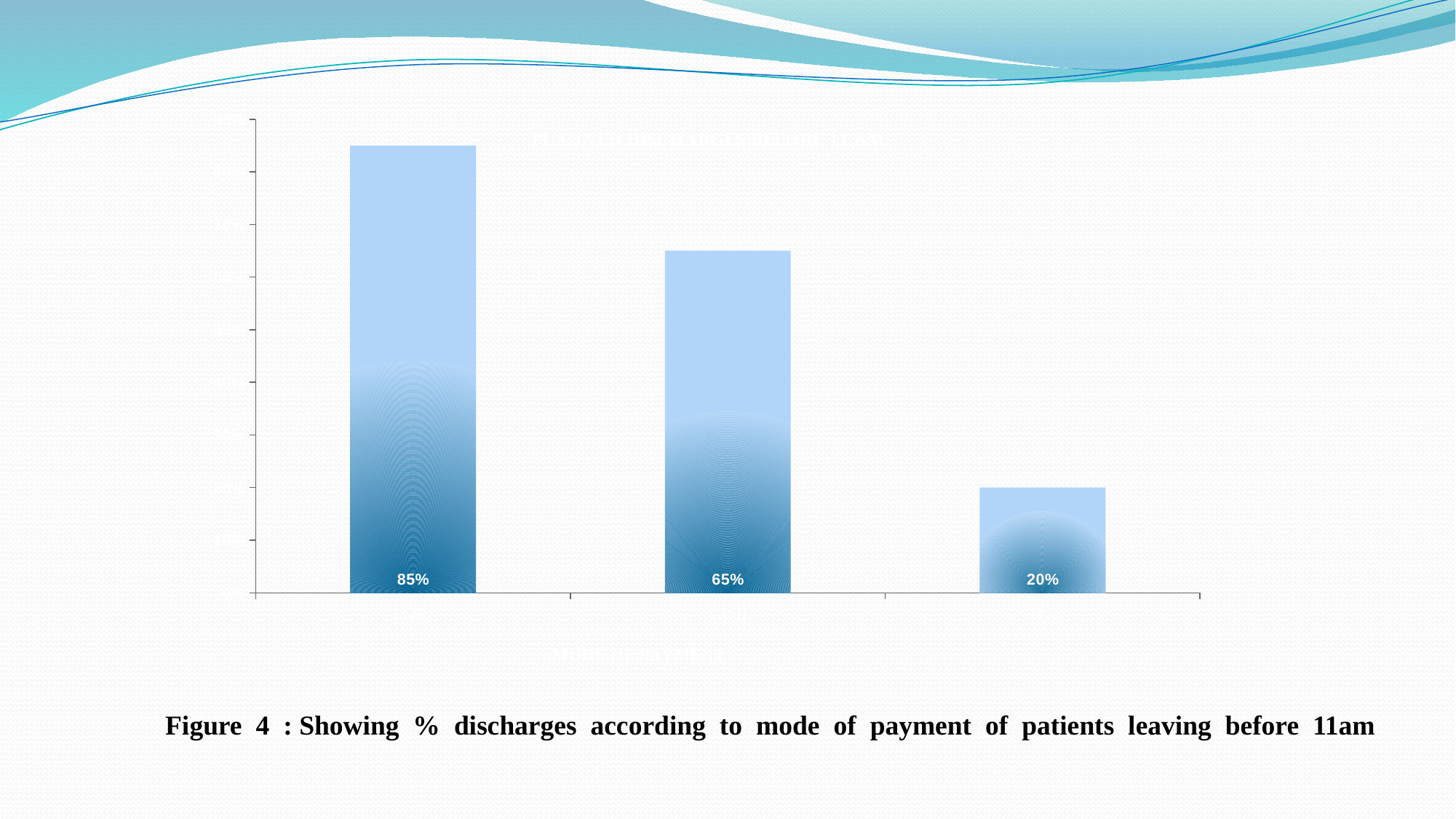
What is the difference between the values of the middle and rightmost bars? 45% What kind of chart is shown on the slide? bar chart What is the value shown on the leftmost bar? 85% Which bar has the lowest value: the left, middle, or right bar? right What is the value shown on the middle bar? 65% What is the value shown on the rightmost bar? 20% Which bar has the highest value: the left, middle, or right bar? left What is the difference between the values of the leftmost and middle bars? 20% How many bars are plotted in the chart? 3 Do the bar values rise or fall from left to right? fall Which is larger, the value of the middle bar or the rightmost bar? middle bar What is the difference between the values of the leftmost and rightmost bars? 65%